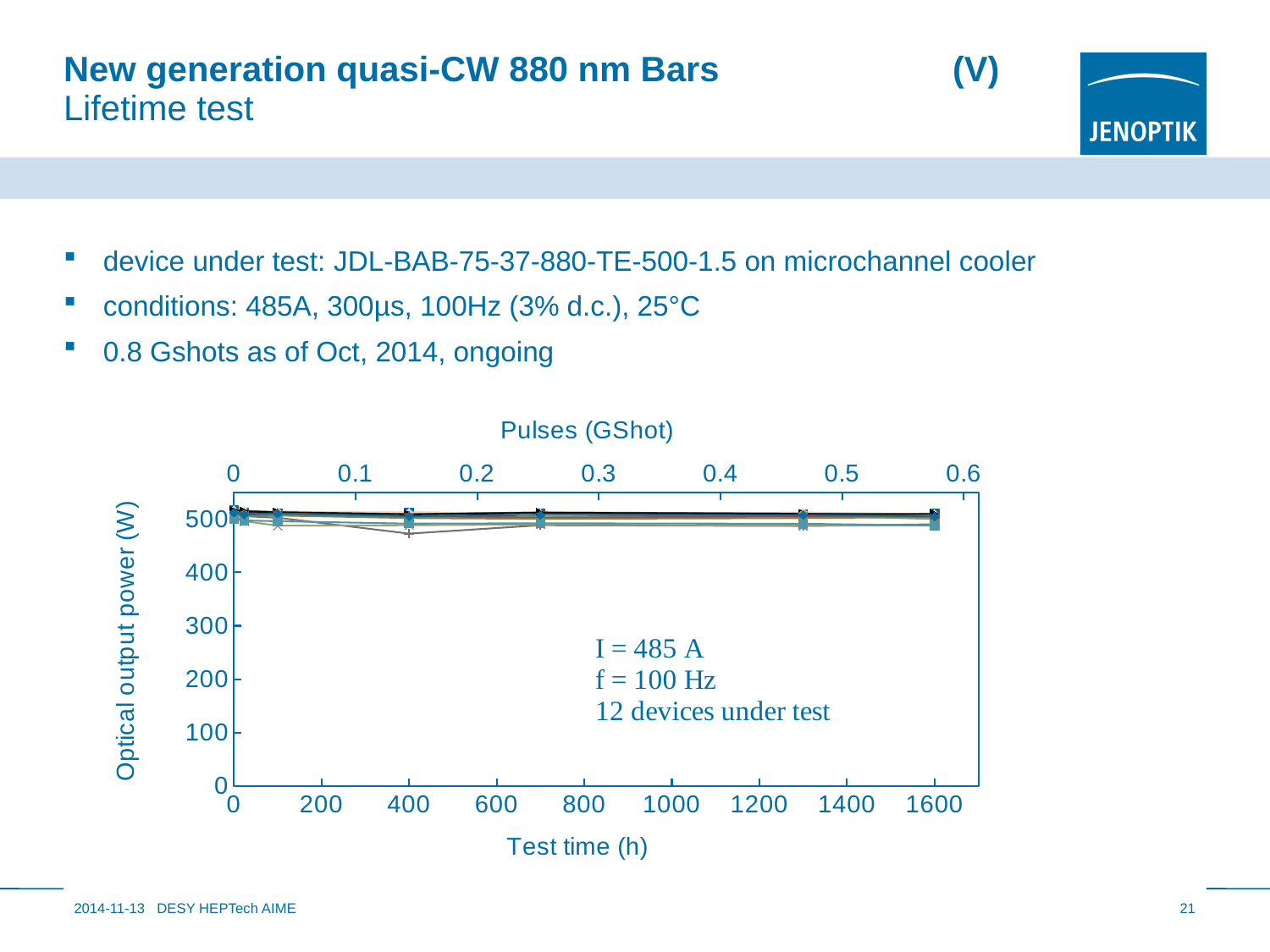
Is the optical output power of the devices at 1600 h greater or less than 400 W? greater According to the annotation inside the chart, how many devices are under test? 12 What drive current is stated in the annotation inside the chart? I = 485 A What kind of chart is shown on the slide? line chart What pulse frequency is stated in the annotation inside the chart? f = 100 Hz What is the largest tick value shown on the Test time (h) axis? 1600 Do the optical output power curves rise, fall, or stay roughly flat as test time increases from 0 to 1600 h? stay roughly flat Is the optical output power of the devices at 800 h greater or less than 300 W? greater What is the label of the vertical axis of the chart? Optical output power (W) What is the label of the bottom horizontal axis of the chart? Test time (h)